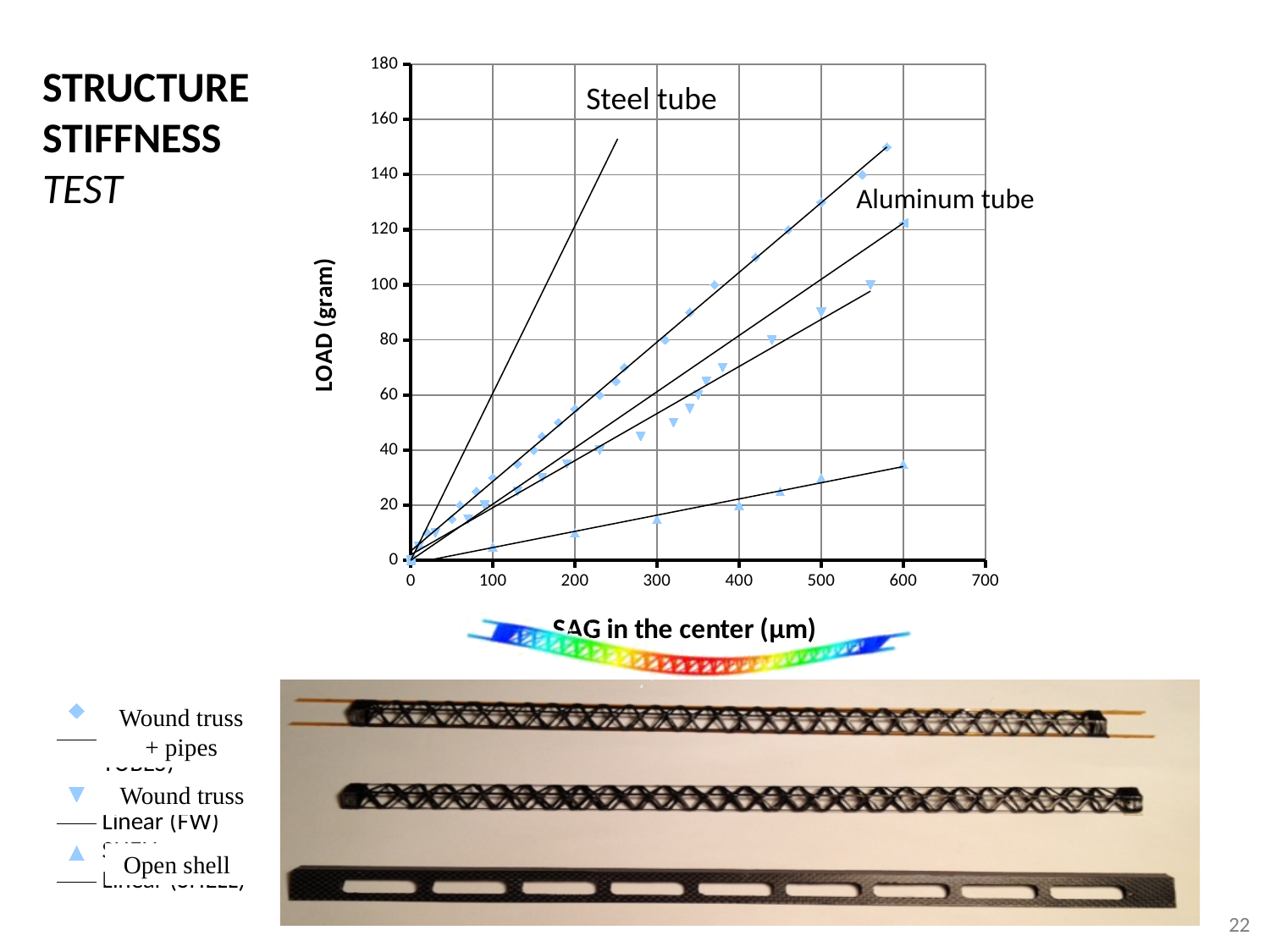
At a sag of about 500 µm, which series carries the higher load: Wound truss + pipes or Open shell? Wound truss + pipes Is the load for the Wound truss series at a sag of about 560 µm greater or less than 80? greater How many marker series does the chart's legend list? 3 Is the load for the Wound truss + pipes series at a sag of about 580 µm greater or less than 140? greater What is the title of the horizontal axis of the chart? SAG in the center (µm) Is the load for the Open shell series at a sag of about 500 µm greater or less than 20? greater Which plotted series has the lowest load for a given sag? Open shell Does the load rise or fall as the sag in the center increases? rises What is the title of the vertical axis of the chart? LOAD (gram) What kind of chart is shown on the slide? scatter chart Which of the two reference lines is steeper, Steel tube or Aluminum tube? Steel tube